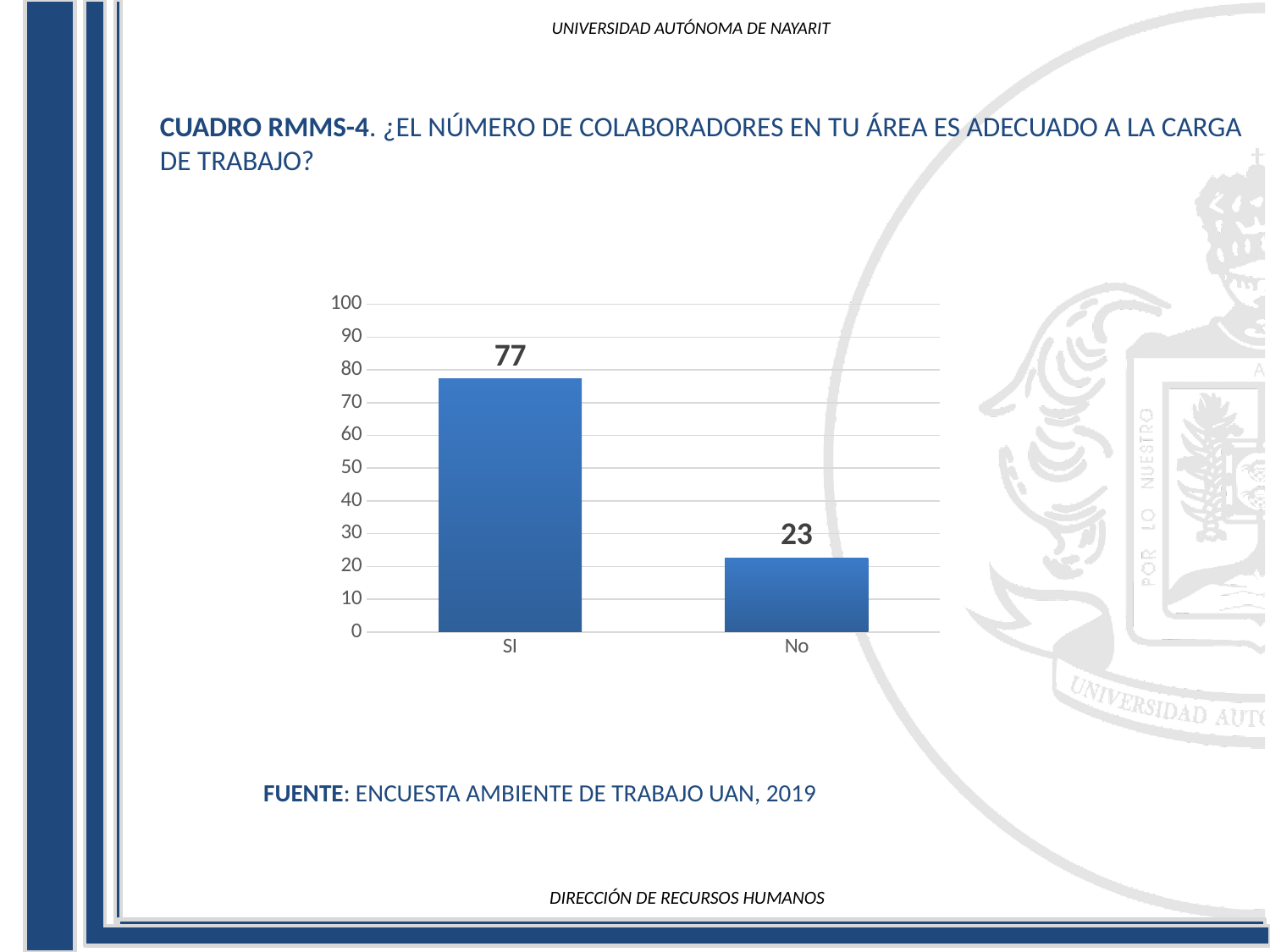
Is the value for No greater or less than 30? less Which category has the highest value? SI What is the value for SI? 77 What kind of chart is shown on the slide? bar chart What is the total of the two values shown in the chart? 100 Is the value for SI greater or less than 50? greater What is the value for No? 23 What is the source cited below the chart? ENCUESTA AMBIENTE DE TRABAJO UAN, 2019 Which is larger, the value for SI or the value for No? SI How many categories are shown on the x axis? 2 Which category has the lowest value? No What is the difference between the values for SI and No? 54